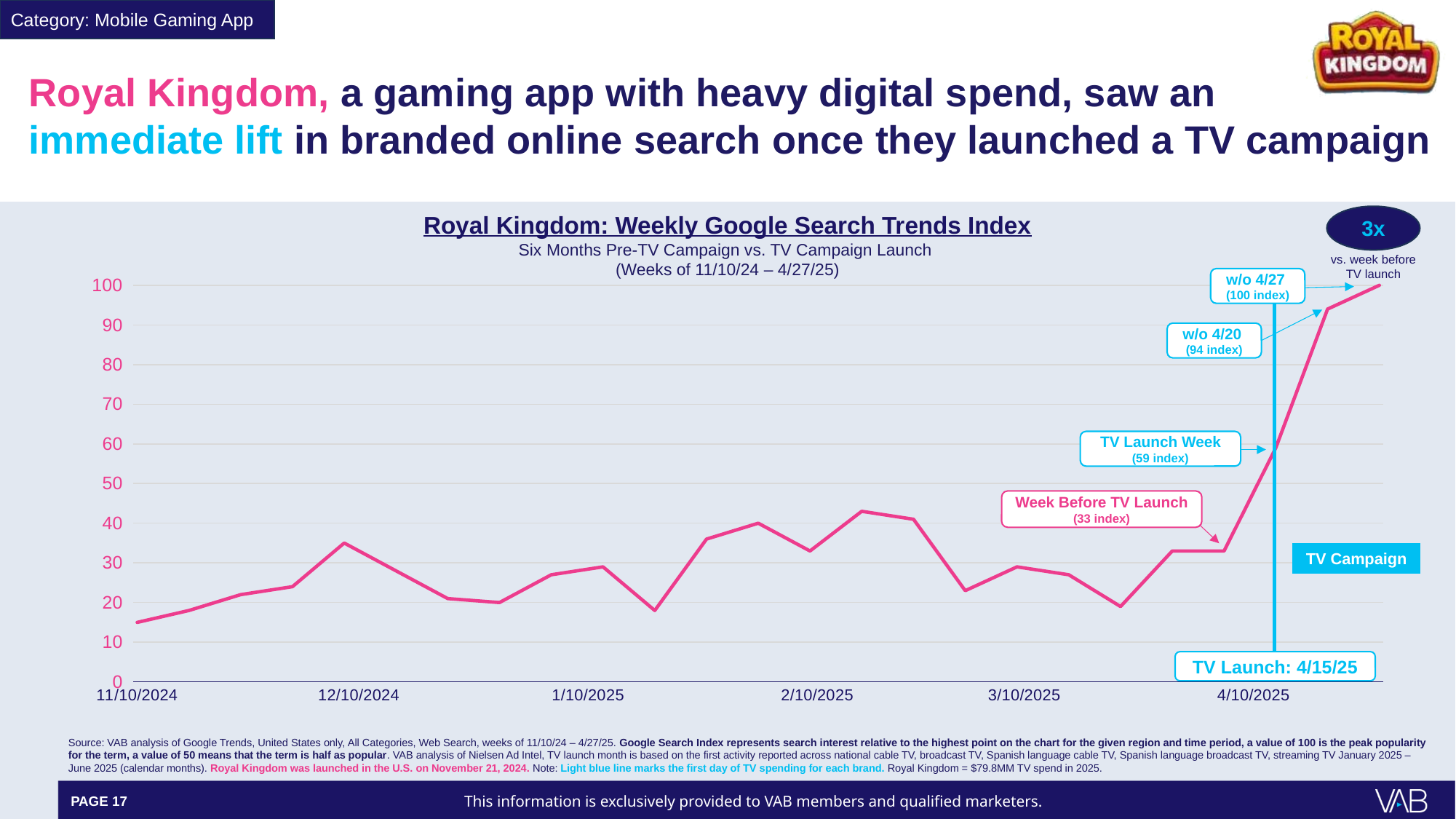
Which has a higher search index: the week of 4/20 or the TV Launch Week? w/o 4/20 What is the search index value for the week of 4/20? 94 What is the search index value for the Week Before TV Launch? 33 What is the search index value for the TV Launch Week? 59 What kind of chart is shown on the slide? Line chart Does the search index rise or fall after the TV launch on 4/15/25? Rise By how much did the search index rise from the Week Before TV Launch to the TV Launch Week? 26 What is the title of the chart? Royal Kingdom: Weekly Google Search Trends Index Is the search index value for the week of 11/10/2024 greater or less than 20? less Which week has the highest search index on the chart? w/o 4/27 What is the difference in search index between the week of 4/27 and the week of 4/20? 6 What is the search index value for the week of 4/27? 100